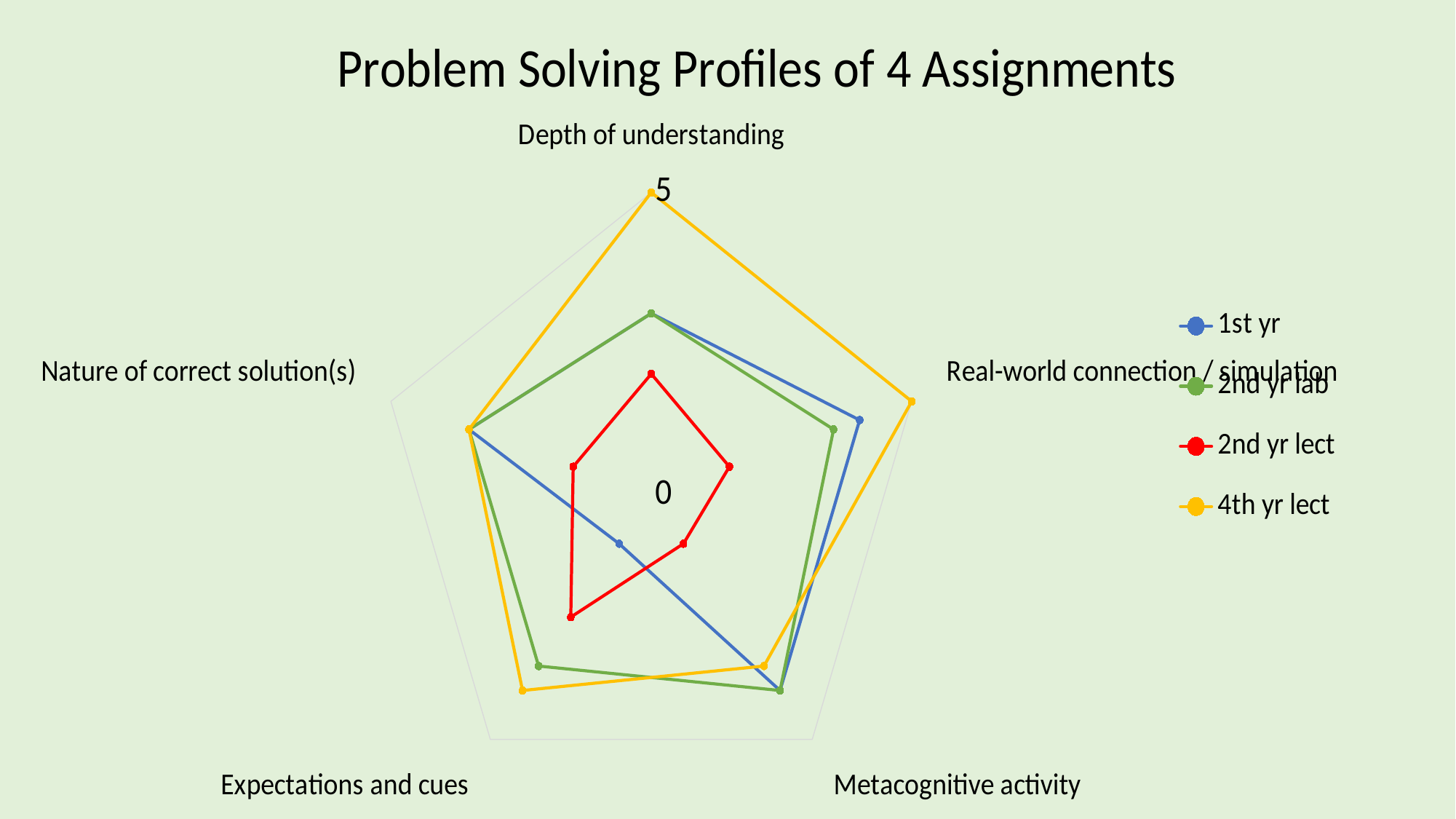
What is the title of the chart? Problem Solving Profiles of 4 Assignments Which is larger for Real-world connection / simulation: 1st yr or 2nd yr lect? 1st yr Which series has the lowest value for Expectations and cues? 1st yr How many categories (axes) does the radar chart have? 5 What kind of chart is shown on the slide? Radar chart What is the value for 4th yr lect on Depth of understanding? 5 Which series has the highest value for Depth of understanding? 4th yr lect Which series has the lowest value for Depth of understanding? 2nd yr lect Which is larger for Real-world connection / simulation: 4th yr lect or 2nd yr lab? 4th yr lect On which category does 1st yr have its lowest value? Expectations and cues Which colour represents the 4th yr lect series? Yellow How many series does the legend list? 4